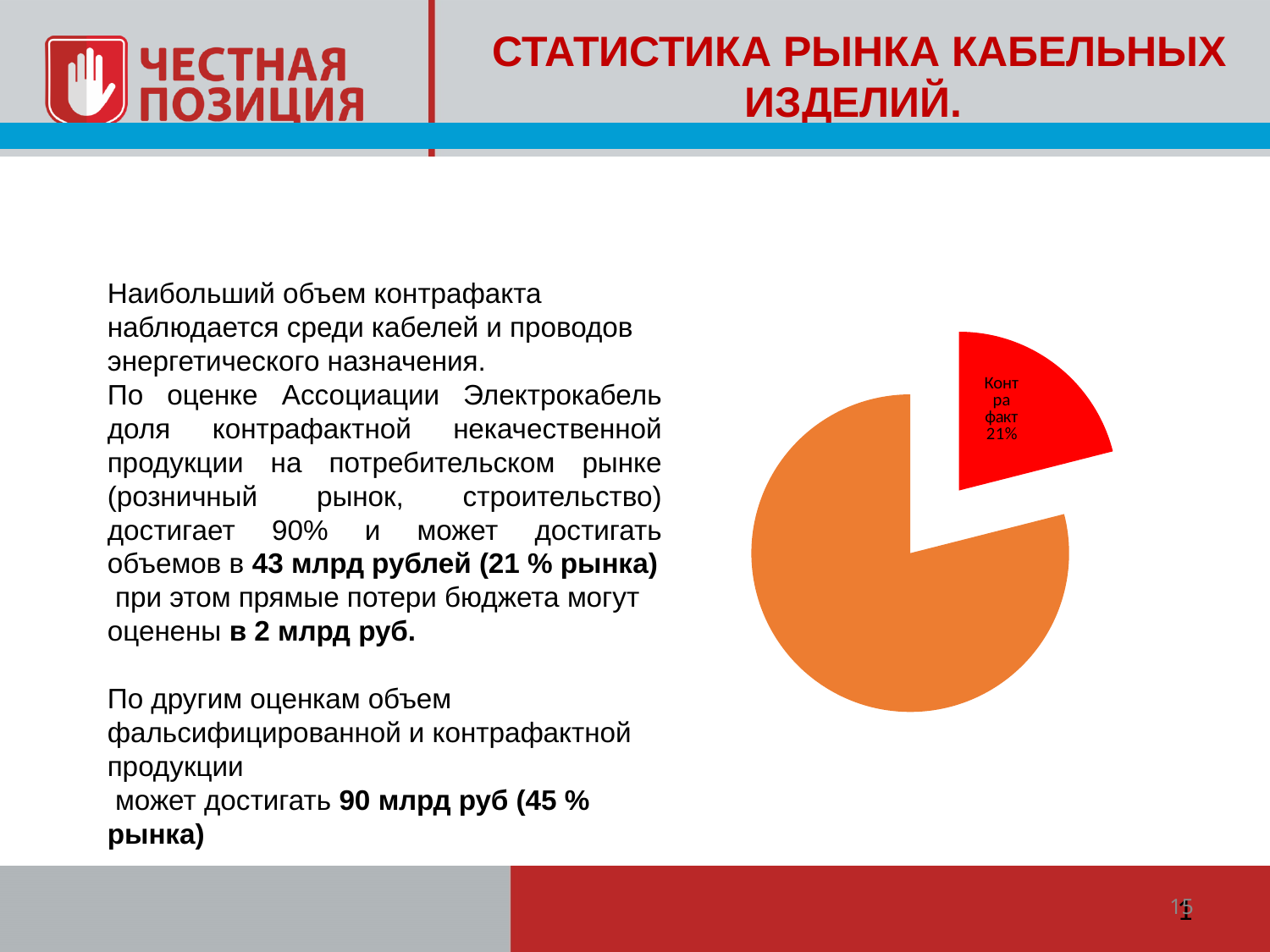
What colour is the Контрафакт slice in the pie chart? red Which slice of the pie chart is the largest? the unlabeled orange slice Is the Контрафакт slice of the pie chart greater or less than half of the pie? less How many slices does the pie chart have? 2 Which slice of the pie chart is pulled out (exploded) from the rest of the pie? Контрафакт What kind of chart is shown on the slide? pie chart Which slice of the pie chart is the smallest? Контрафакт Which is larger in the pie chart: the Контрафакт slice or the orange slice? the orange slice What percentage is shown for the Контрафакт slice of the pie chart? 21%